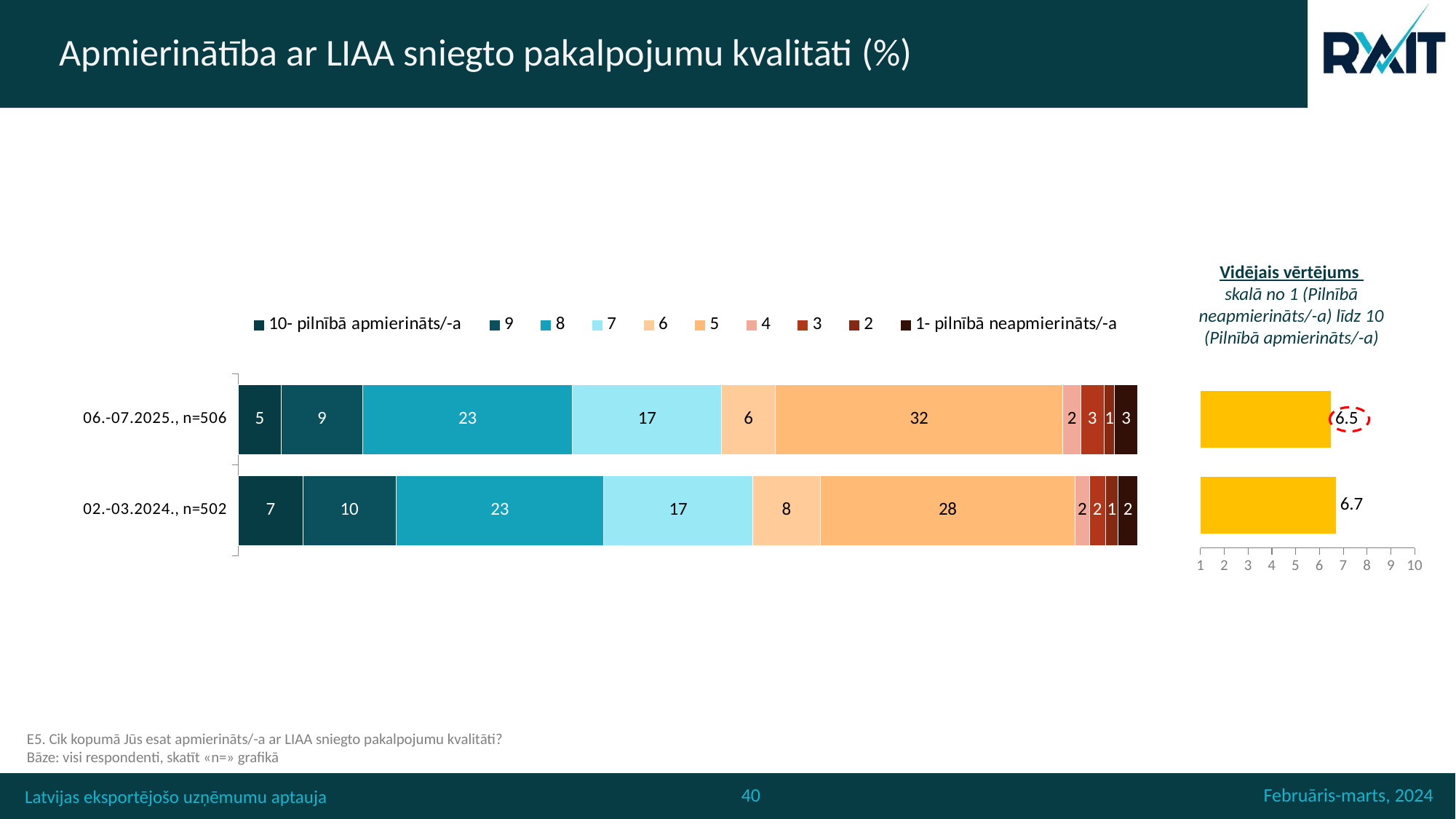
In the "Vidējais vērtējums" chart on the right, which period has the higher average rating? 02.-03.2024., n=502 How many categories (survey periods) are shown in the stacked bar chart? 2 How many series does the legend of the stacked bar chart list? 10 In the "Vidējais vērtējums" chart on the right, what is the average rating for 06.-07.2025., n=506? 6.5 In the stacked bar chart, what is the difference between the "9" segment for 02.-03.2024., n=502 and for 06.-07.2025., n=506? 1 In the stacked bar chart, what is the difference between the "5" segment for 06.-07.2025., n=506 and for 02.-03.2024., n=502? 4 In the stacked bar chart, what is the value of the "10- pilnībā apmierināts/-a" segment for 02.-03.2024., n=502? 7 In the "Vidējais vērtējums" chart on the right, what is the average rating for 02.-03.2024., n=502? 6.7 In the stacked bar chart, what is the value of the "8" segment for 02.-03.2024., n=502? 23 In the stacked bar chart, which series has the largest segment in the 06.-07.2025., n=506 bar? 5 In the stacked bar chart, what is the value of the "5" segment for 06.-07.2025., n=506? 32 What kind of chart is the main chart on the left of the slide? Stacked bar chart